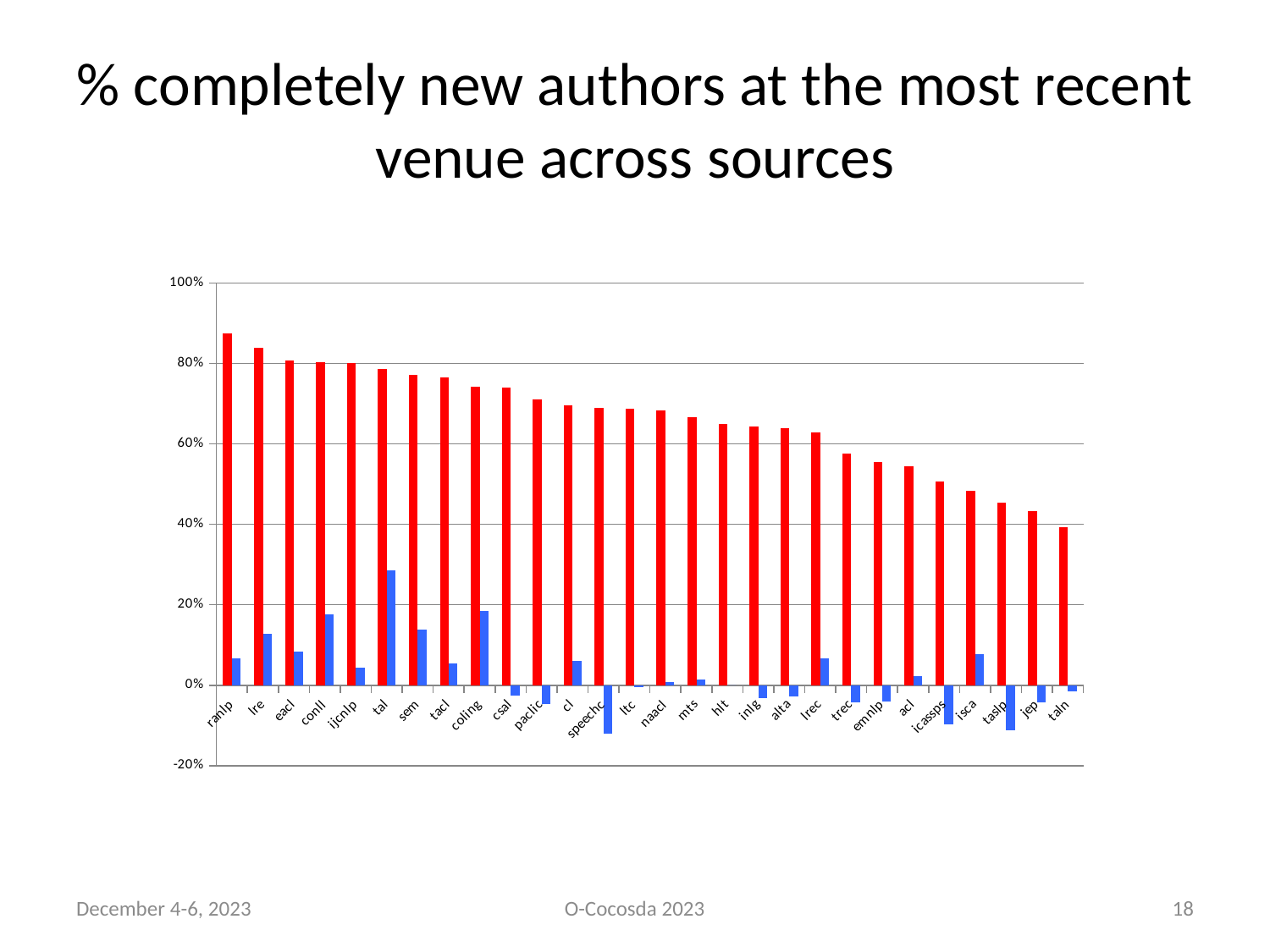
How many venue categories are shown along the x axis? 28 Is the red bar for ranlp greater or less than 80%? greater Which venue has the highest red bar? ranlp Which venue has the lowest red bar? taln Which has the larger blue bar, tal or lre? tal What kind of chart is shown on the slide? bar chart Which venue has the highest blue bar? tal Is the red bar for acl greater or less than 60%? less Do the red bars rise or fall from left to right along the x axis? fall What is the title of the chart? % completely new authors at the most recent venue across sources Is the blue bar for tal greater or less than 20%? greater